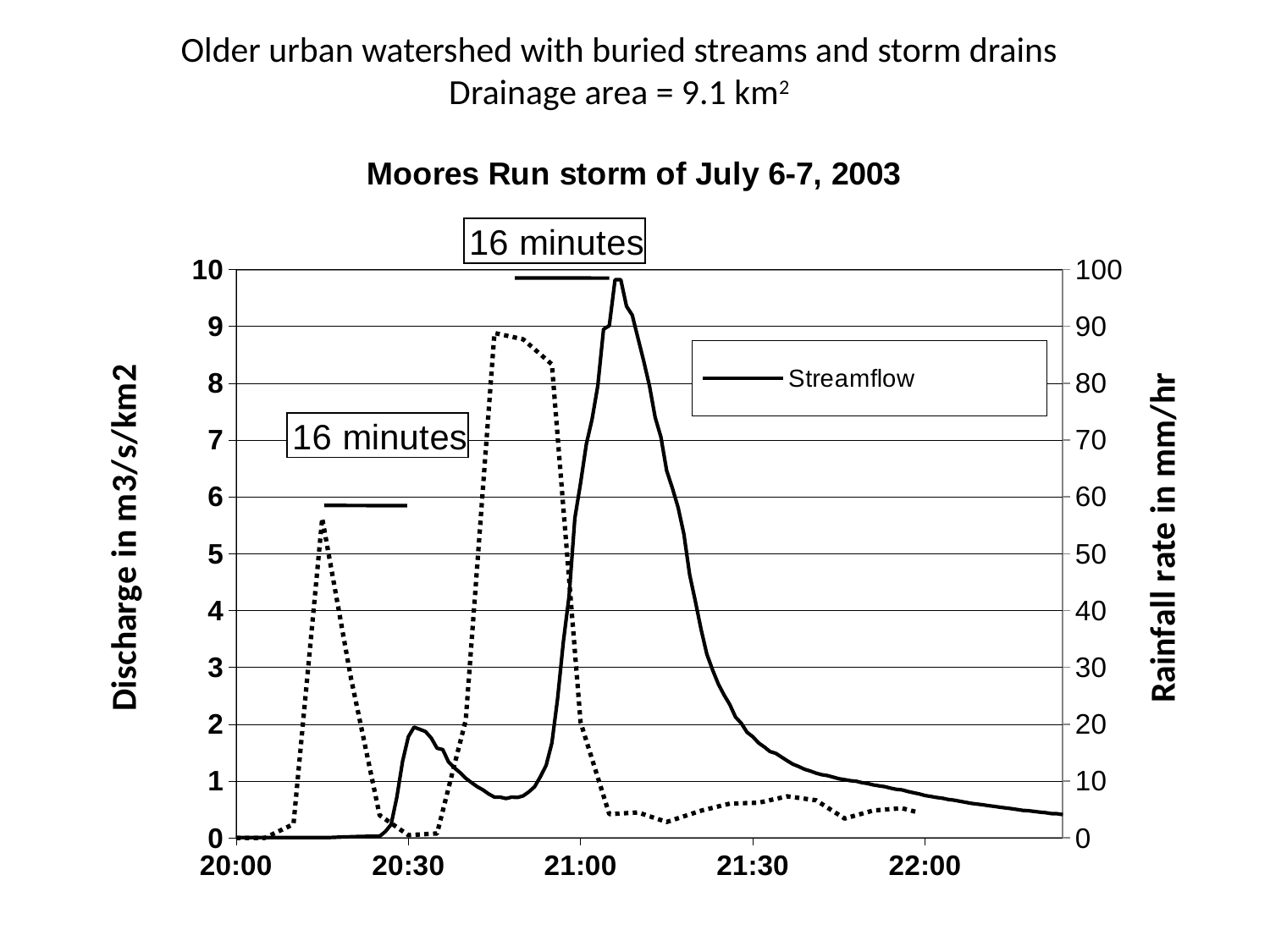
Is the Streamflow value at 20:30 higher or lower than at 21:00? lower Does the Streamflow rise or fall between 21:10 and 22:00? fall Does the Streamflow rise or fall between 20:45 and 21:05? rise What kind of chart is shown on the slide? line chart Is the Streamflow value at 21:00 greater or less than 4 m3/s/km2? greater How many labelled time ticks are on the x axis? 5 What duration is written in the annotation boxes above the rainfall peaks? 16 minutes How many series does the chart legend list? 1 Is the Streamflow value at 21:30 greater or less than 3 m3/s/km2? less What is the title of the chart? Moores Run storm of July 6-7, 2003 Is the peak Streamflow value greater or less than 9 m3/s/km2? greater